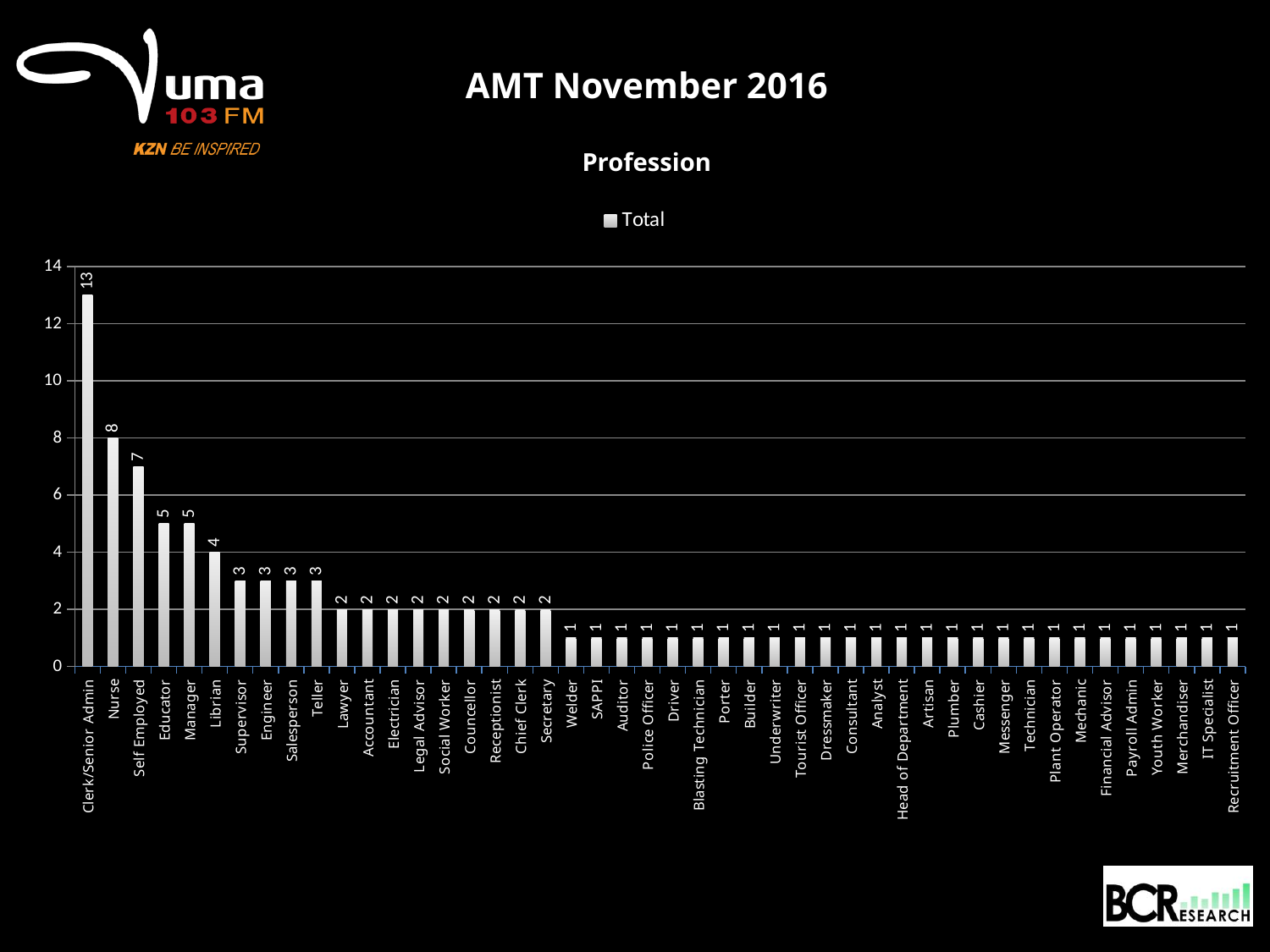
What is the value for Clerk/Senior Admin? 13 Which is larger, the value for Nurse or the value for Manager? Nurse Is the value for Clerk/Senior Admin greater or less than 12? greater What is the value for Nurse? 8 What is the difference between the values for Self Employed and Educator? 2 What kind of chart is shown on the slide? bar chart What is the value for Self Employed? 7 How many series does the legend list? 1 What is the difference between the values for Clerk/Senior Admin and Nurse? 5 Which profession has the highest value? Clerk/Senior Admin What is the title of the chart? Profession What is the value for Librian? 4